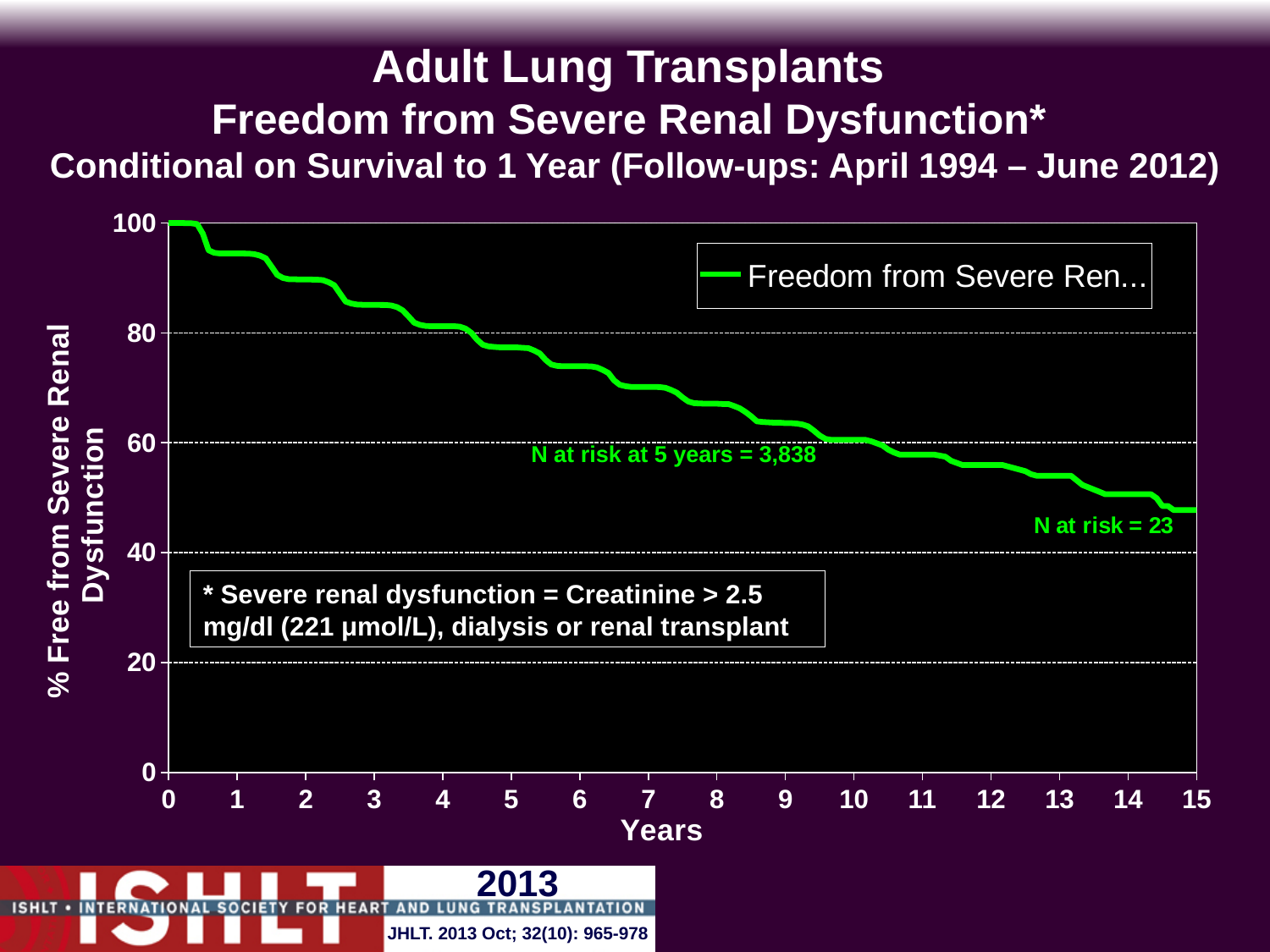
Is the value for freedom from severe renal dysfunction at 15 years greater or less than 40? greater How many series does the legend list? 1 Is the value for freedom from severe renal dysfunction at 15 years greater or less than 60? less What is the N at risk at 5 years printed on the chart? 3,838 What is the highest value shown on the y axis of the chart? 100 Is the value for freedom from severe renal dysfunction at 7 years greater or less than 60? greater What is the N at risk printed near the end of the curve? 23 Does the plotted line rise or fall as the years increase along the x axis? fall What is the label on the x axis of the chart? Years What kind of chart is shown on the slide? line chart